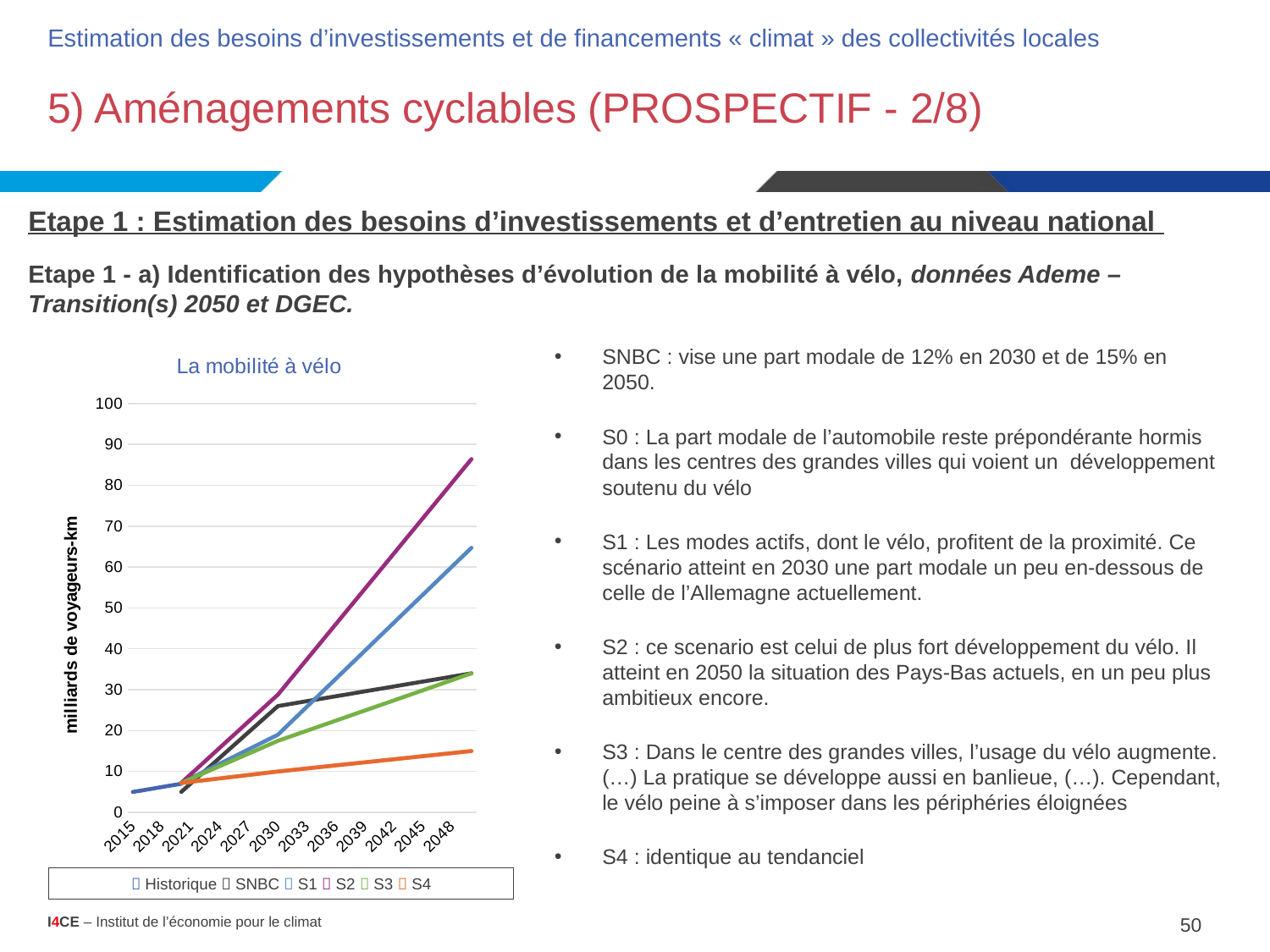
How many series does the chart legend list? 6 Is the value for S4 in 2048 greater or less than 20? less What is the label of the vertical axis of the chart? milliards de voyageurs-km Which series has the lowest value in 2048? S4 In 2048, which series has the larger value, S1 or S2? S2 Does the S2 series rise or fall from 2021 to 2048? rise What is the title of the chart? La mobilité à vélo How many year labels are shown on the x axis of the chart? 12 What kind of chart is shown on the slide? line chart Which series has the highest value in 2048? S2